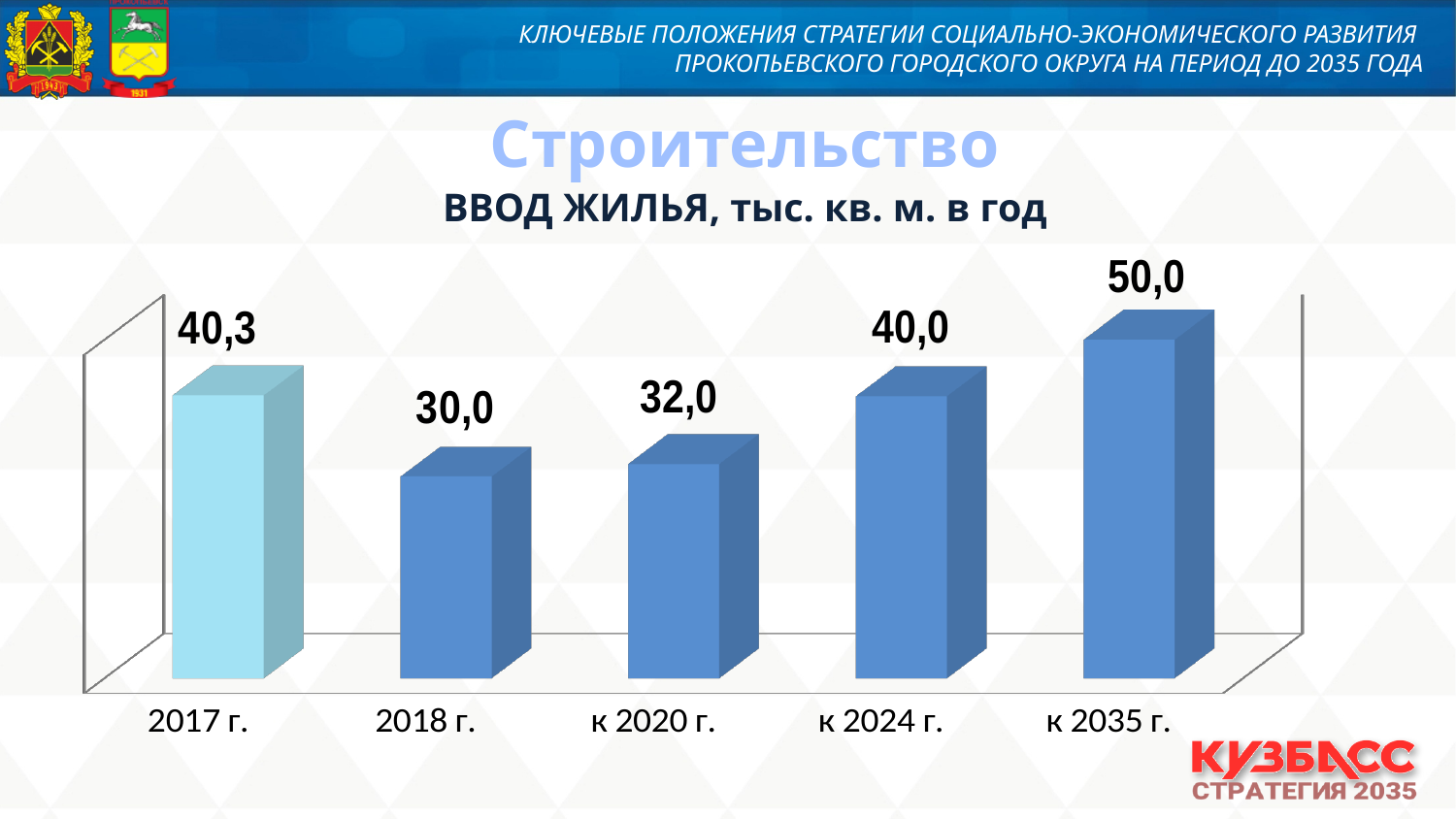
What is the difference between the values for 2017 г. and 2018 г.? 10,3 Do the values rise or fall from 2018 г. to к 2035 г.? rise How many categories are shown on the chart? 5 What is the value for 2017 г.? 40,3 Which category has the highest value? к 2035 г. What is the value for к 2020 г.? 32,0 Which is larger, the value for 2017 г. or the value for к 2024 г.? 2017 г. What is the title of the chart? ВВОД ЖИЛЬЯ, тыс. кв. м. в год What kind of chart is shown on the slide? bar chart What is the difference between the values for к 2035 г. and к 2024 г.? 10,0 What is the value for к 2035 г.? 50,0 Which category has the lowest value? 2018 г.